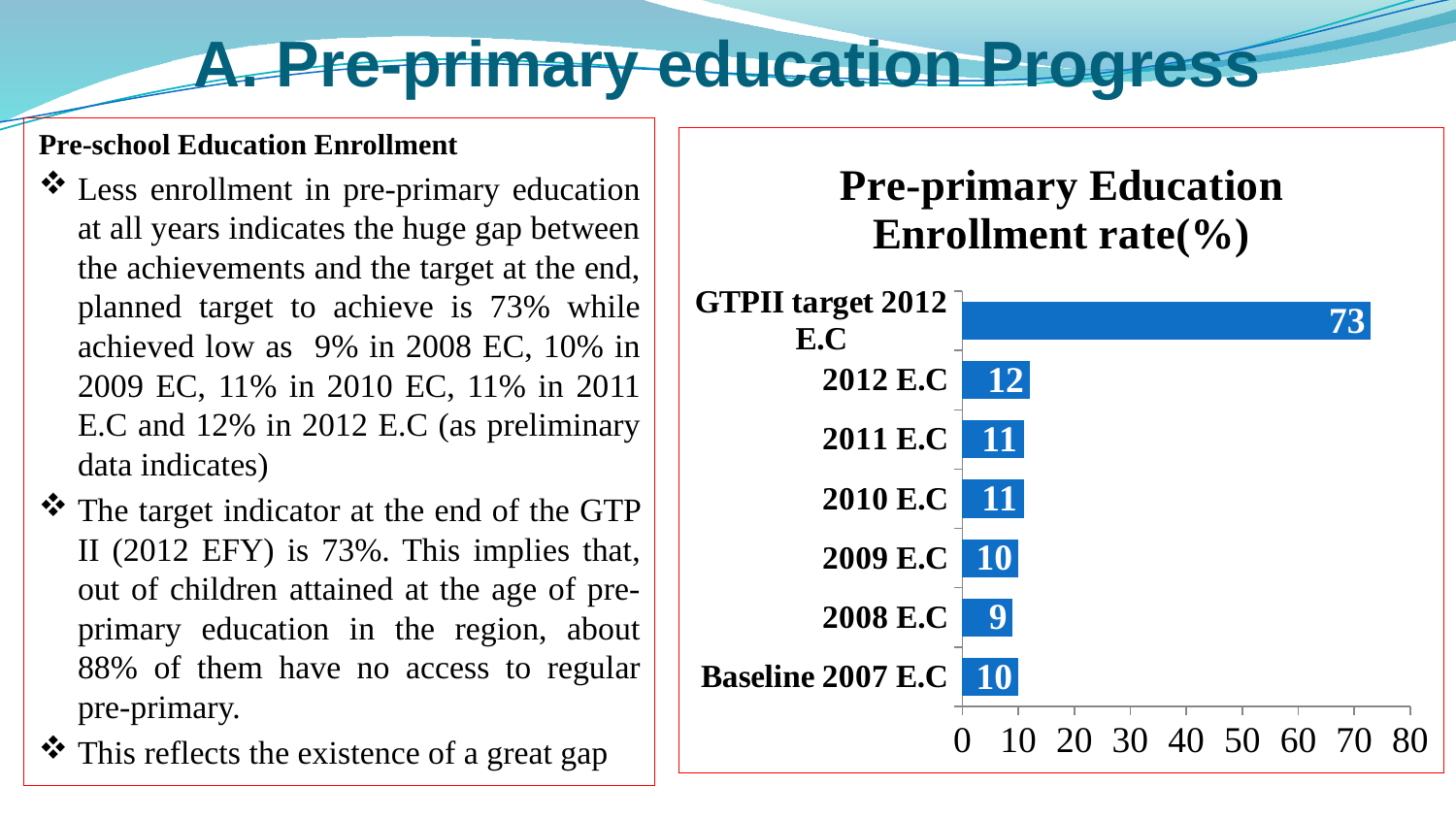
What is the value for GTPII target 2012 E.C in the chart? 73 What is the value for Baseline 2007 E.C in the chart? 10 What is the maximum value shown on the x axis of the chart? 80 What kind of chart is shown on the slide? bar chart Which category has the highest value in the chart? GTPII target 2012 E.C What is the difference between the GTPII target 2012 E.C value and the 2012 E.C value? 61 What is the value for 2012 E.C in the Pre-primary Education Enrollment rate(%) chart? 12 What is the title of the chart? Pre-primary Education Enrollment rate(%) Is the value for GTPII target 2012 E.C greater or less than 70? greater How many categories are shown in the chart? 7 Which category has the lowest value in the chart? 2008 E.C Which is larger, the value for 2009 E.C or the value for 2012 E.C? 2012 E.C